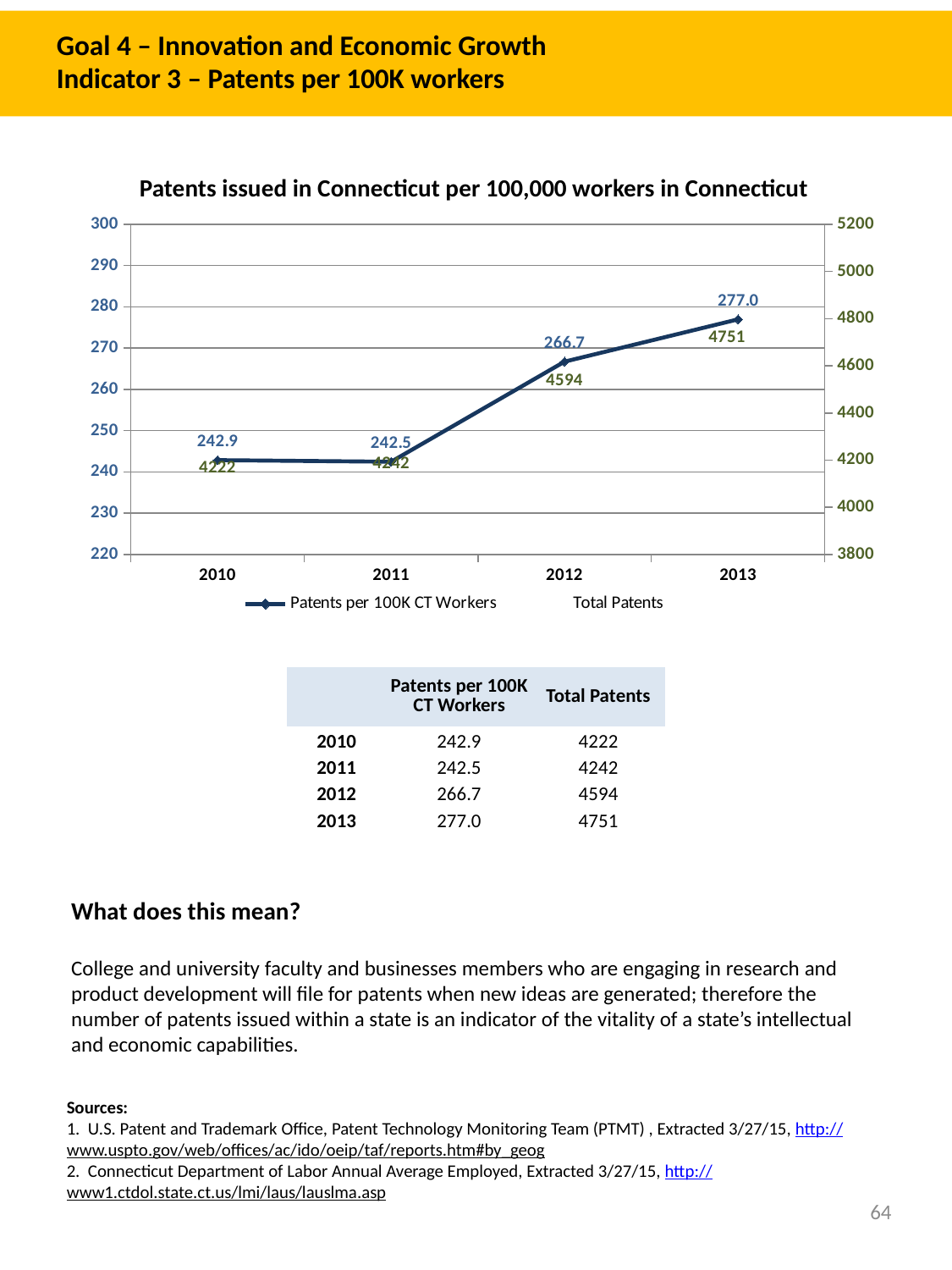
What is the value of Total Patents in 2012? 4594 Which year has the lowest value for Total Patents? 2010 How many series does the legend list? 2 What is the difference in Total Patents between 2013 and 2010? 529 Which is larger, Total Patents in 2011 or Total Patents in 2012? 2012 What is the difference in Patents per 100K CT Workers between 2013 and 2012? 10.3 What is the title of the chart? Patents issued in Connecticut per 100,000 workers in Connecticut What is the value of Patents per 100K CT Workers in 2013? 277.0 How many years are plotted on the x axis? 4 What kind of chart is shown? Line chart Which year has the highest value for Patents per 100K CT Workers? 2013 What is the value of Patents per 100K CT Workers in 2010? 242.9